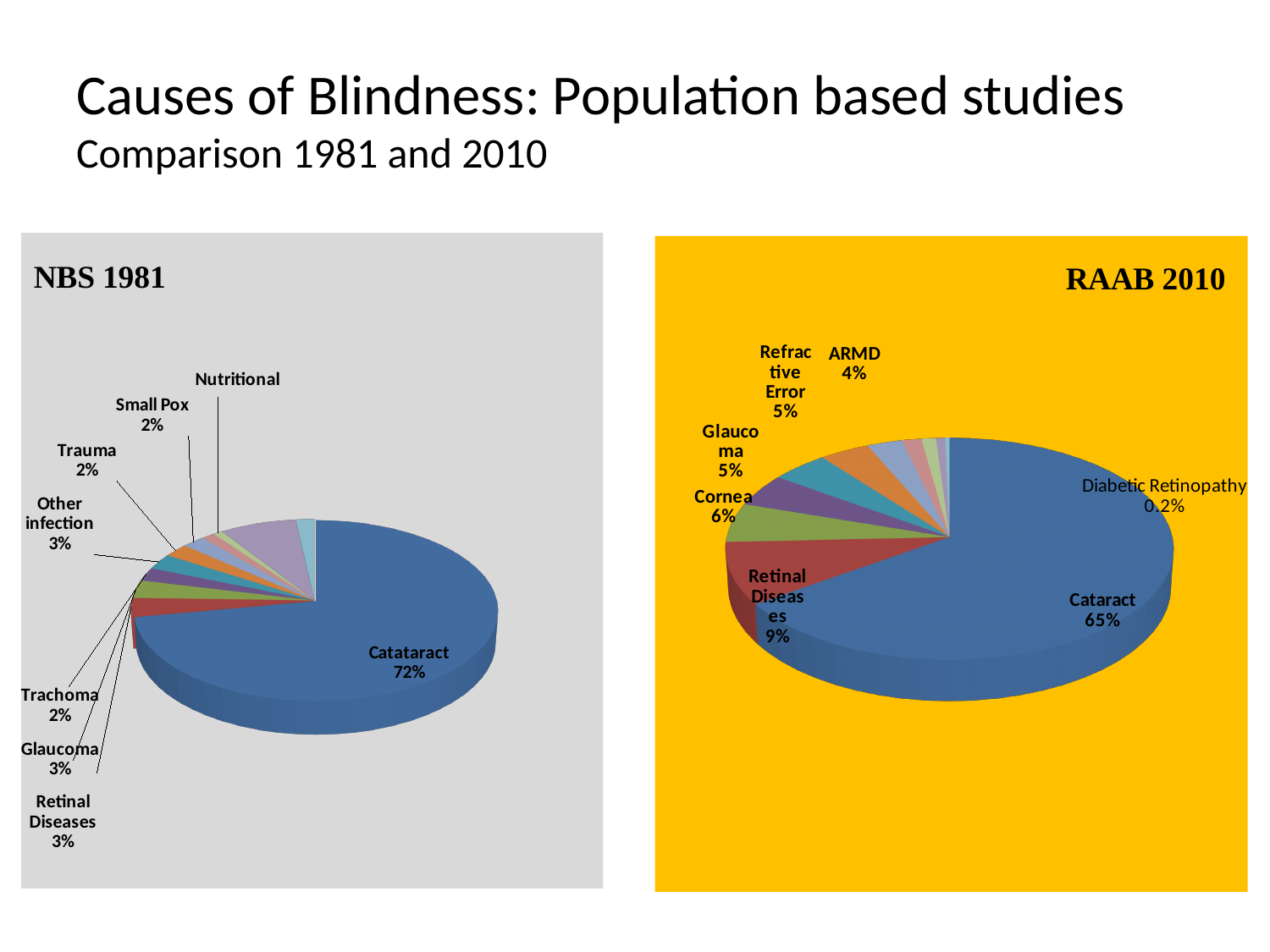
By how many percentage points does the Catataract share in NBS 1981 exceed the Cataract share in RAAB 2010? 7 percentage points In the RAAB 2010 pie chart, which labelled cause has the smallest share? Diabetic Retinopathy What kind of chart is used for the NBS 1981 data? Pie chart In the NBS 1981 pie chart, what percentage is shown for Small Pox? 2% In the RAAB 2010 pie chart, what is the difference between the Retinal Diseases share and the Cornea share? 3 percentage points In the RAAB 2010 pie chart, what share of blindness is attributed to Cataract? 65% In the RAAB 2010 pie chart, which has the larger share, Cornea or Glaucoma? Cornea In the RAAB 2010 pie chart, which cause has the largest share? Cataract In the RAAB 2010 pie chart, what percentage is shown for Diabetic Retinopathy? 0.2% In the RAAB 2010 pie chart, what percentage is shown for Retinal Diseases? 9% In the NBS 1981 pie chart, what percentage is shown for Other infection? 3% In the NBS 1981 pie chart, what share of blindness is attributed to Catataract? 72%